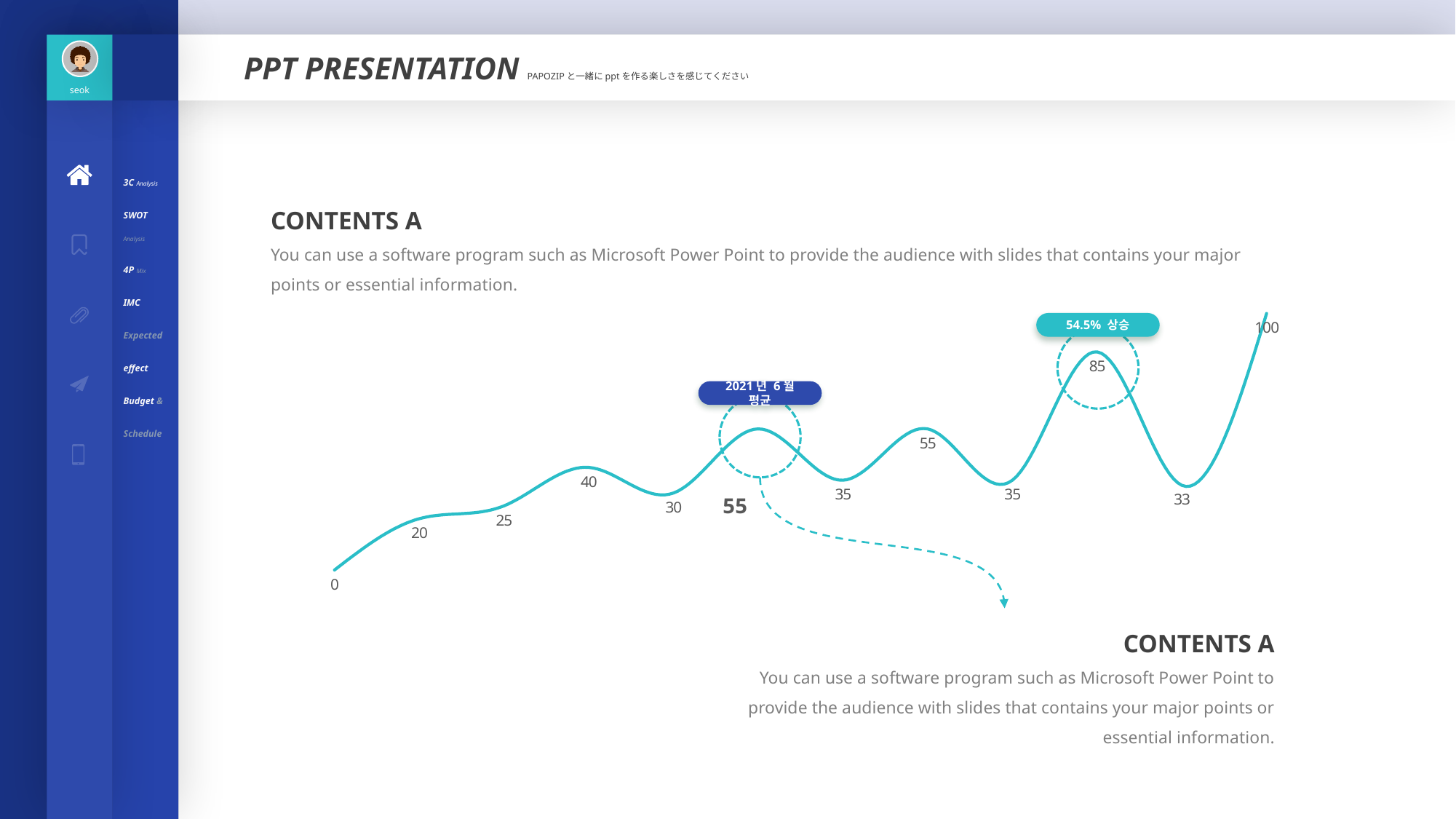
What is the difference between the last data point (100) and the point just before it (33)? 67 What is the highest value labelled on the line chart? 100 What is the lowest value labelled on the line chart? 0 What kind of chart is shown on the slide? line chart What is the value of the first data point on the line chart? 0 What value is labelled at the point marked with the "2021년 6월 평균" callout? 55 What value is labelled at the point marked with the "54.5% 상승" callout? 85 Which is larger on the line chart: the point labelled 85 or the point labelled 33? 85 Overall, do the values on the line chart rise or fall from the first point to the last point? rise What is the value of the last data point on the line chart? 100 What is the difference between the highest and lowest labelled values on the line chart? 100 How many data points are labelled on the line chart? 12